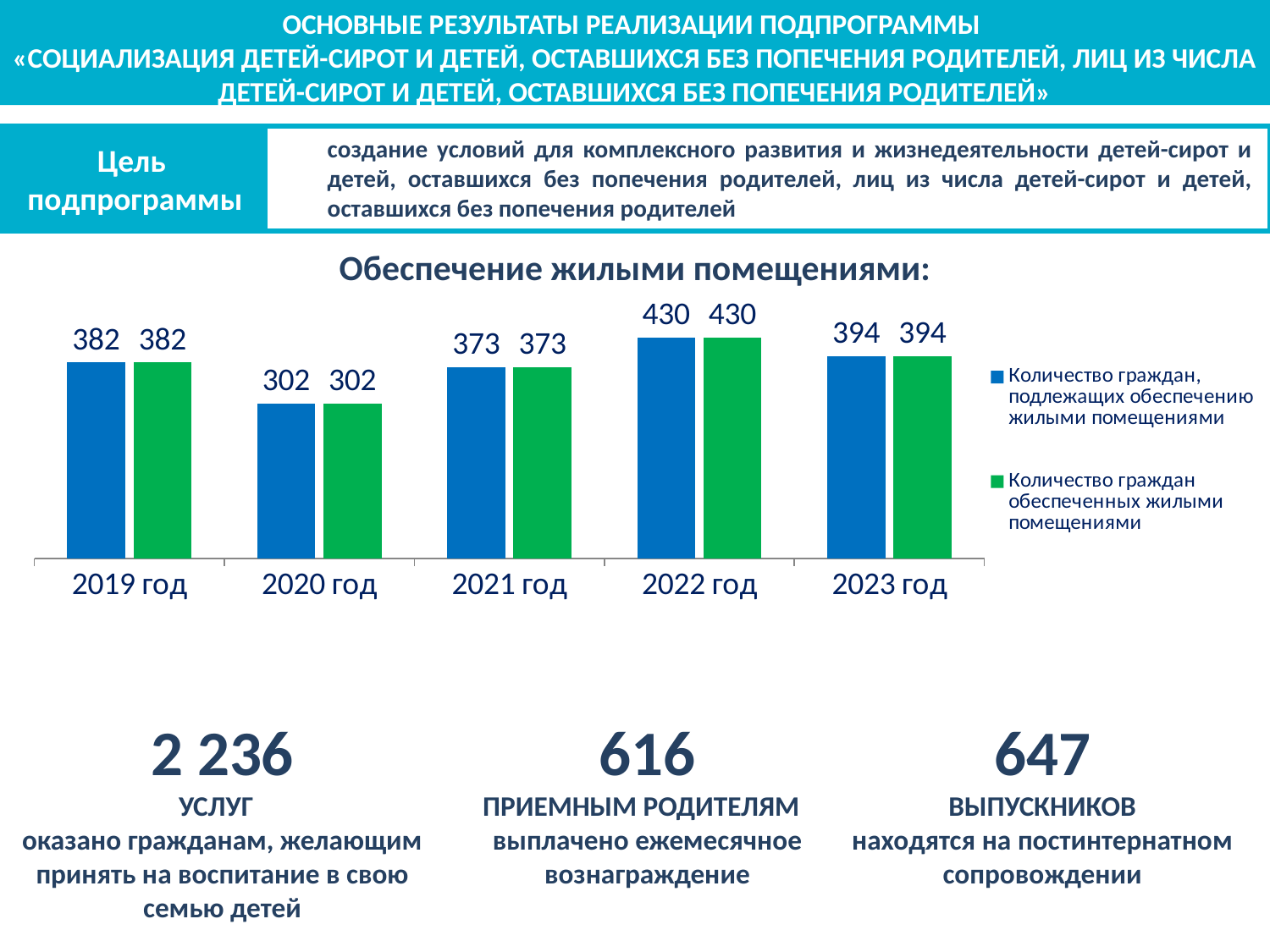
How many years are shown on the x axis of the chart? 5 What is the value for 'Количество граждан, подлежащих обеспечению жилыми помещениями' in 2023 год? 394 Does the value for 'Количество граждан обеспеченных жилыми помещениями' rise or fall from 2022 год to 2023 год? fall Which year has the lowest value for 'Количество граждан, подлежащих обеспечению жилыми помещениями'? 2020 год How many series does the chart legend list? 2 Which year has the highest value for 'Количество граждан обеспеченных жилыми помещениями'? 2022 год What is the value for 'Количество граждан, подлежащих обеспечению жилыми помещениями' in 2019 год? 382 What is the value for 'Количество граждан обеспеченных жилыми помещениями' in 2022 год? 430 Which is larger: the 2021 год value or the 2023 год value for 'Количество граждан, подлежащих обеспечению жилыми помещениями'? 2023 год What colour are the bars for 'Количество граждан обеспеченных жилыми помещениями'? green What kind of chart is shown under the heading 'Обеспечение жилыми помещениями'? bar chart What is the difference between the 2022 год and 2020 год values for 'Количество граждан обеспеченных жилыми помещениями'? 128